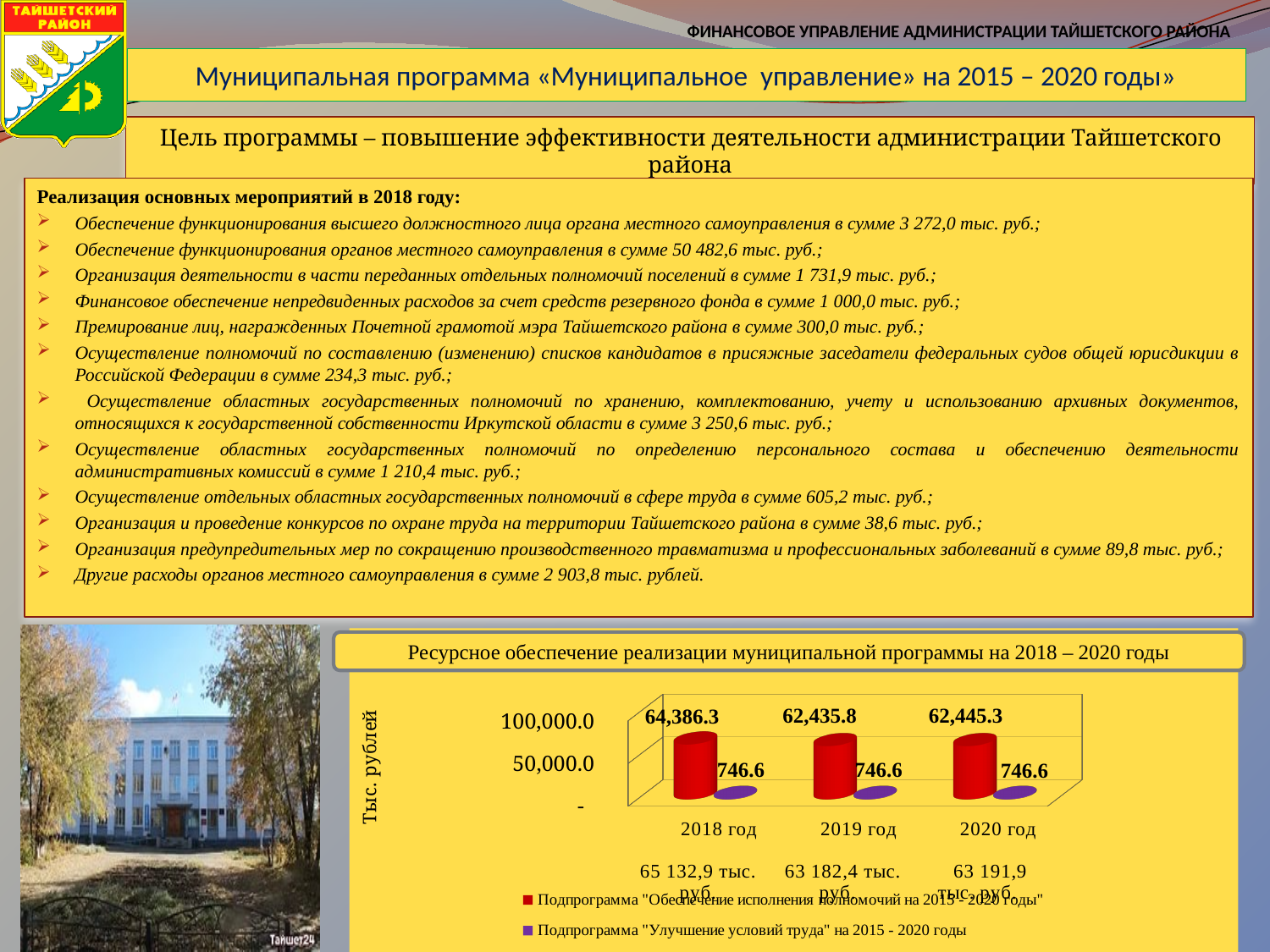
How many years are shown on the x axis of the chart? 3 What is the value for the series "Подпрограмма "Улучшение условий труда" на 2015 - 2020 годы" in 2020 год? 746.6 What is the difference between the 2018 год and 2020 год values for "Подпрограмма "Обеспечение исполнения полномочий на 2015 - 2020 годы""? 1,941.0 Which is larger for "Подпрограмма "Обеспечение исполнения полномочий на 2015 - 2020 годы"": the 2019 год value or the 2020 год value? 2020 год What is the value for the series "Подпрограмма "Обеспечение исполнения полномочий на 2015 - 2020 годы"" in 2019 год? 62,435.8 What is the value for the series "Подпрограмма "Обеспечение исполнения полномочий на 2015 - 2020 годы"" in 2018 год? 64,386.3 What kind of chart is shown under "Ресурсное обеспечение реализации муниципальной программы на 2018 – 2020 годы"? bar chart In which year is the value for "Подпрограмма "Обеспечение исполнения полномочий на 2015 - 2020 годы"" the highest? 2018 год What unit is shown on the vertical axis of the chart? Тыс. рублей Is the 2018 год value for "Подпрограмма "Обеспечение исполнения полномочий на 2015 - 2020 годы"" greater or less than 50,000.0? greater How many series does the chart legend list? 2 In which year is the value for "Подпрограмма "Обеспечение исполнения полномочий на 2015 - 2020 годы"" the lowest? 2019 год